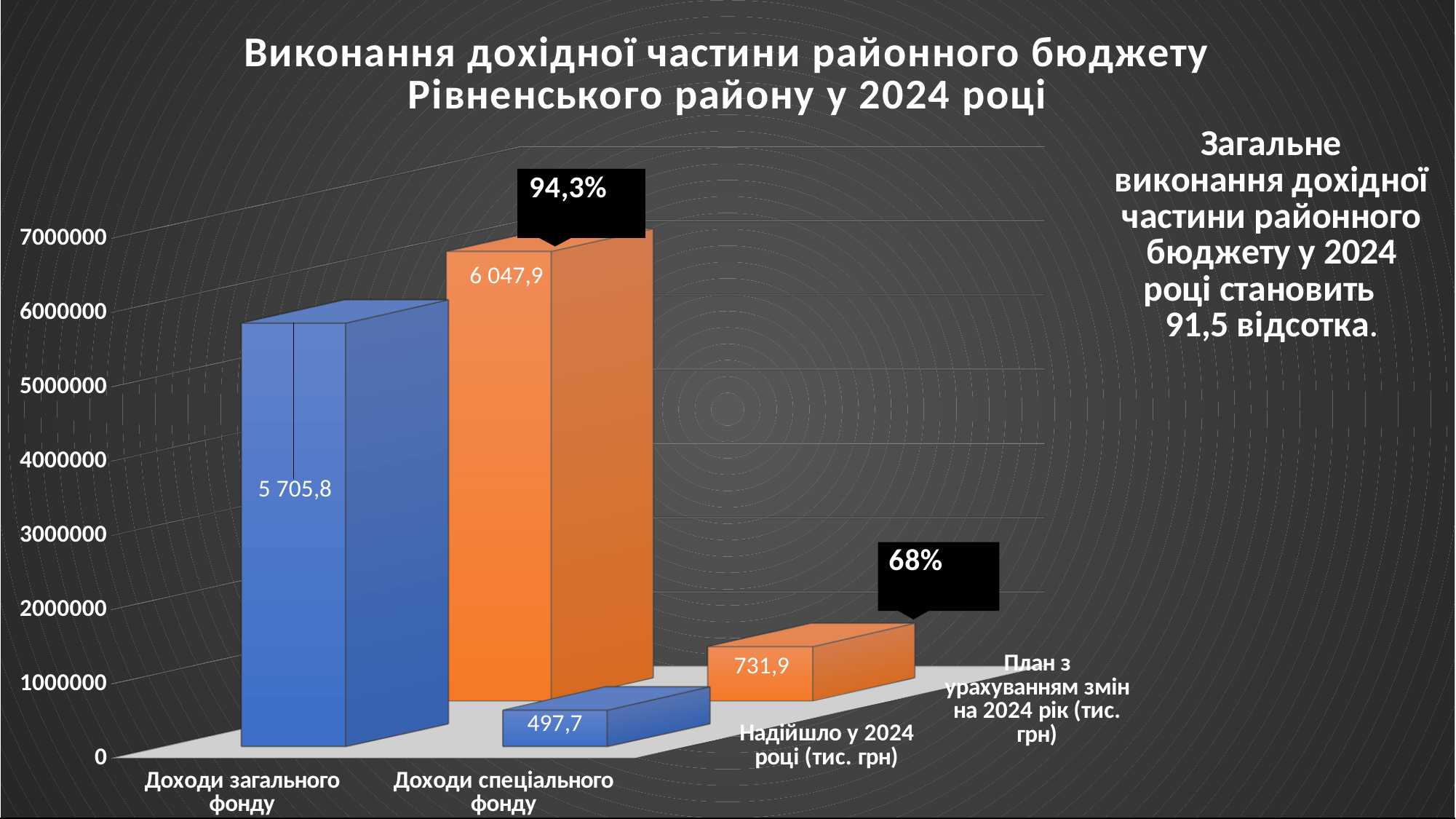
Which bar has the highest value on the chart? План з урахуванням змін на 2024 рік for Доходи загального фонду What is the value of "План з урахуванням змін на 2024 рік (тис. грн)" for "Доходи спеціального фонду"? 731,9 What is the value of "План з урахуванням змін на 2024 рік (тис. грн)" for "Доходи загального фонду"? 6 047,9 What percentage is shown in the callout above the "Доходи загального фонду" plan bar? 94,3% What is the value of "Надійшло у 2024 році (тис. грн)" for "Доходи спеціального фонду"? 497,7 Which is larger for "Доходи спеціального фонду": the received amount or the plan? the plan (731,9) What is the difference between the plan and the received amount for "Доходи загального фонду"? 342,1 What is the difference between the plan and the received amount for "Доходи спеціального фонду"? 234,2 How many categories are shown on the x axis of the chart? 2 Which bar has the lowest value on the chart? Надійшло у 2024 році for Доходи спеціального фонду What type of chart is shown on the slide? bar chart What is the value of "Надійшло у 2024 році (тис. грн)" for "Доходи загального фонду"? 5 705,8